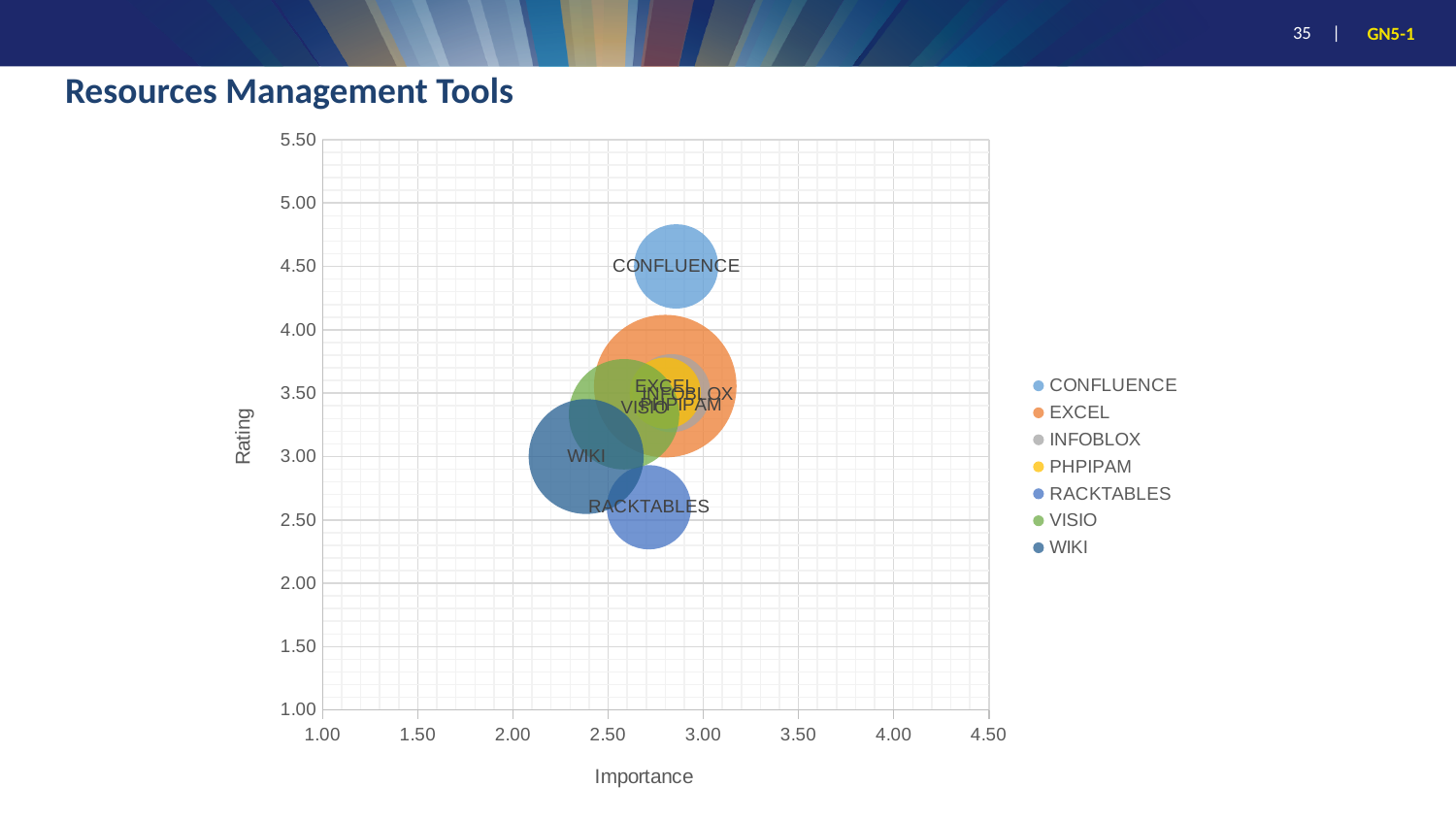
Which tool has the lowest Rating? RACKTABLES What is the title of the horizontal axis? Importance Which tool has the lowest Importance? WIKI Is the Importance for CONFLUENCE greater or less than 2.50? greater Which has a higher Rating, CONFLUENCE or RACKTABLES? CONFLUENCE Which tool has the highest Rating? CONFLUENCE What kind of chart is shown on the slide? Bubble chart How many series does the legend list? 7 Is the Rating for RACKTABLES greater or less than 3.00? less Is the Importance for WIKI greater or less than 2.50? less Which has a higher Importance, WIKI or CONFLUENCE? CONFLUENCE